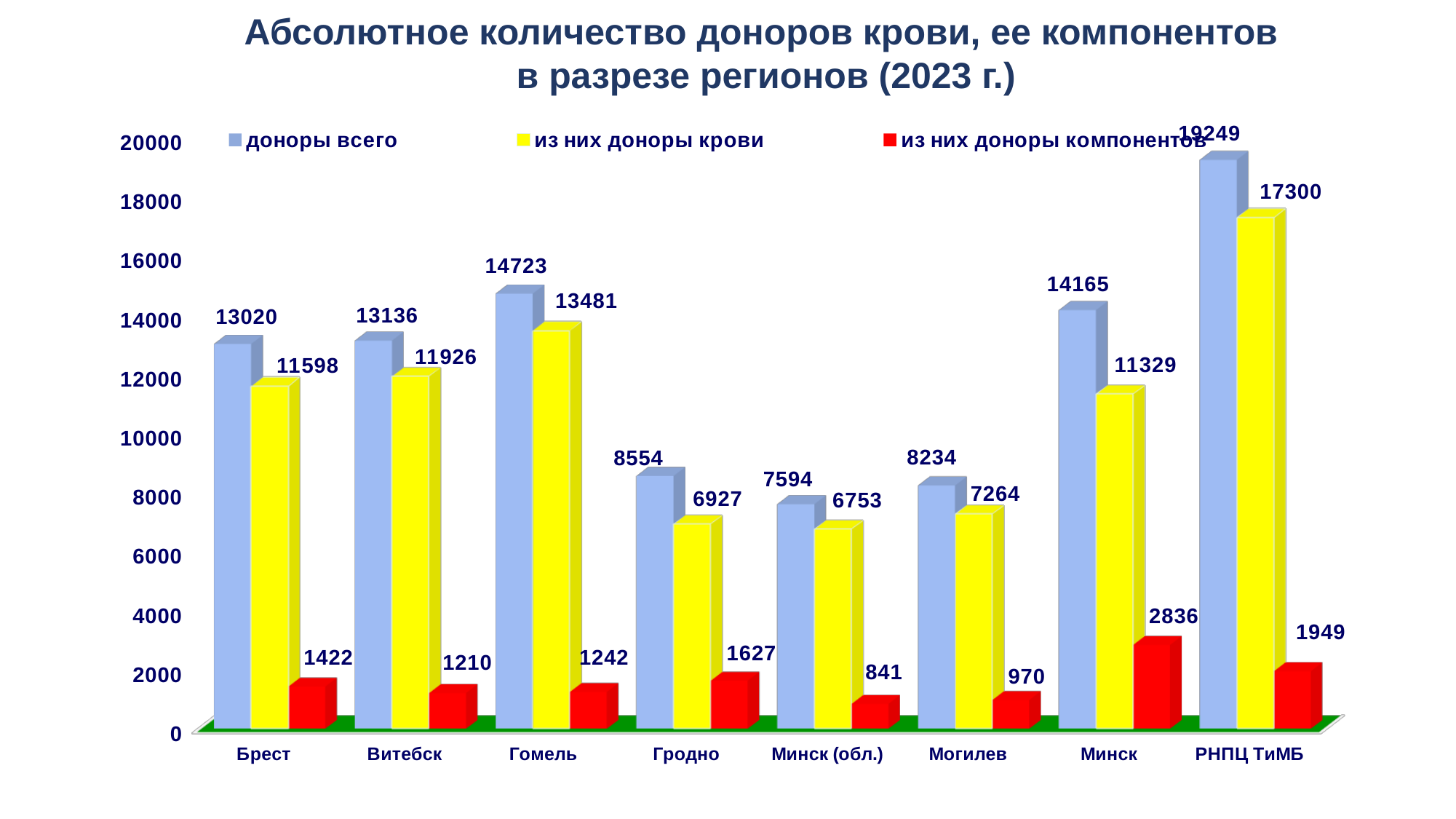
What kind of chart is shown on the slide? bar chart What is the value of 'доноры всего' for Гомель? 14723 What colour represents the series 'из них доноры компонентов'? red How many regions are shown on the x axis? 8 Which region has the highest value for 'доноры всего'? РНПЦ ТиМБ What is the value of 'из них доноры крови' for Минск? 11329 Which is larger: 'из них доноры крови' for Витебск or for Брест? Витебск What is the value of 'из них доноры компонентов' for Гродно? 1627 How many series does the legend list? 3 Is the value of 'доноры всего' for Могилев greater or less than 10000? less What is the difference between 'доноры всего' and 'из них доноры крови' for Брест? 1422 Which region has the lowest value for 'из них доноры компонентов'? Минск (обл.)